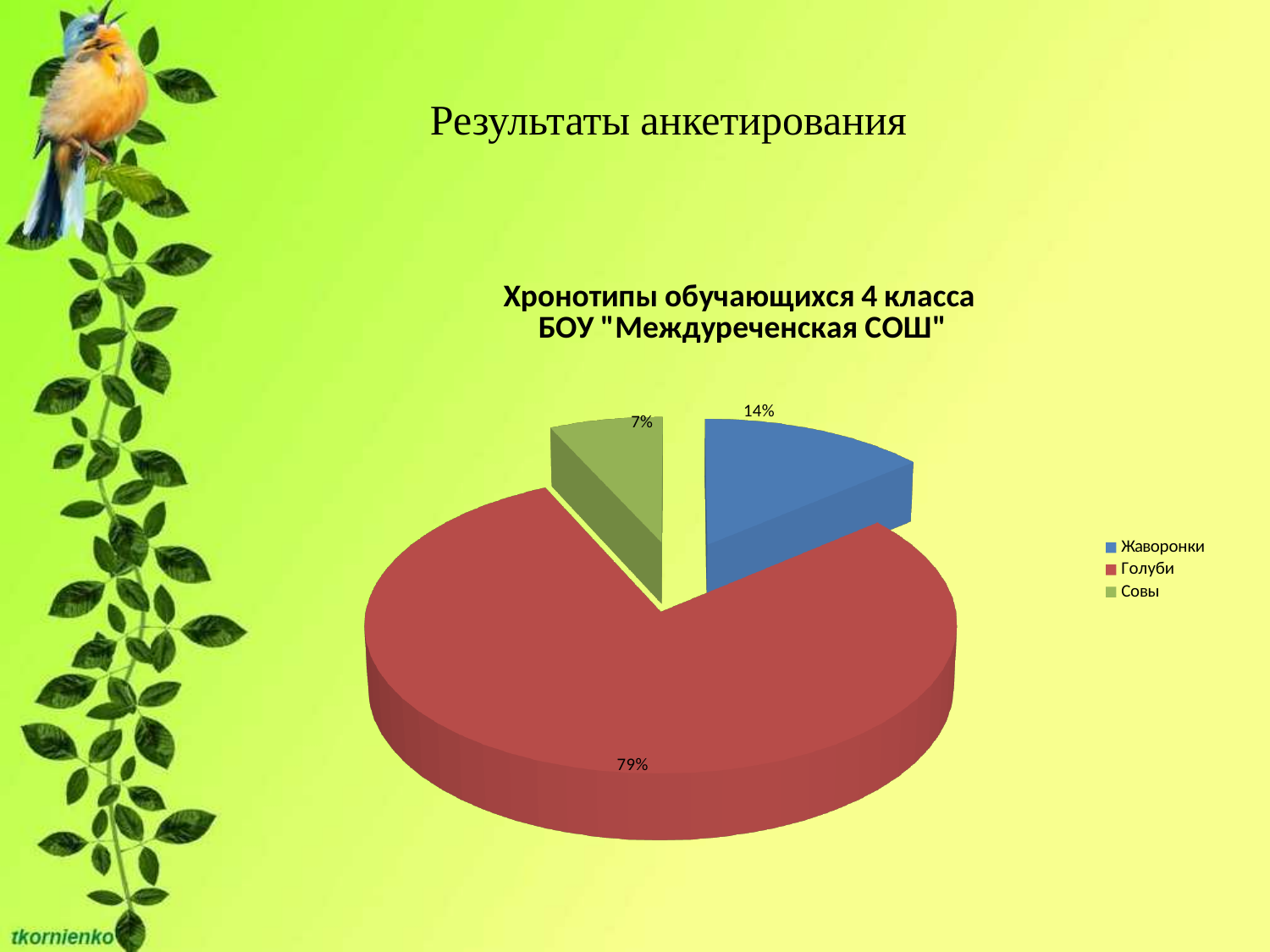
How many entries does the legend list? 3 What is the chart's title? Хронотипы обучающихся 4 класса БОУ "Междуреченская СОШ" What colour is the slice for Голуби? red What share of the pie is Жаворонки? 14% What kind of chart is shown on the slide? pie chart How many slices does the pie chart have? 3 What share of the pie is Совы? 7% Which category has the smallest slice? Совы Which is larger, the share for Жаворонки or the share for Совы? Жаворонки What share of the pie is Голуби? 79% Which category has the largest slice? Голуби What is the difference in percentage points between Голуби and Жаворонки? 65